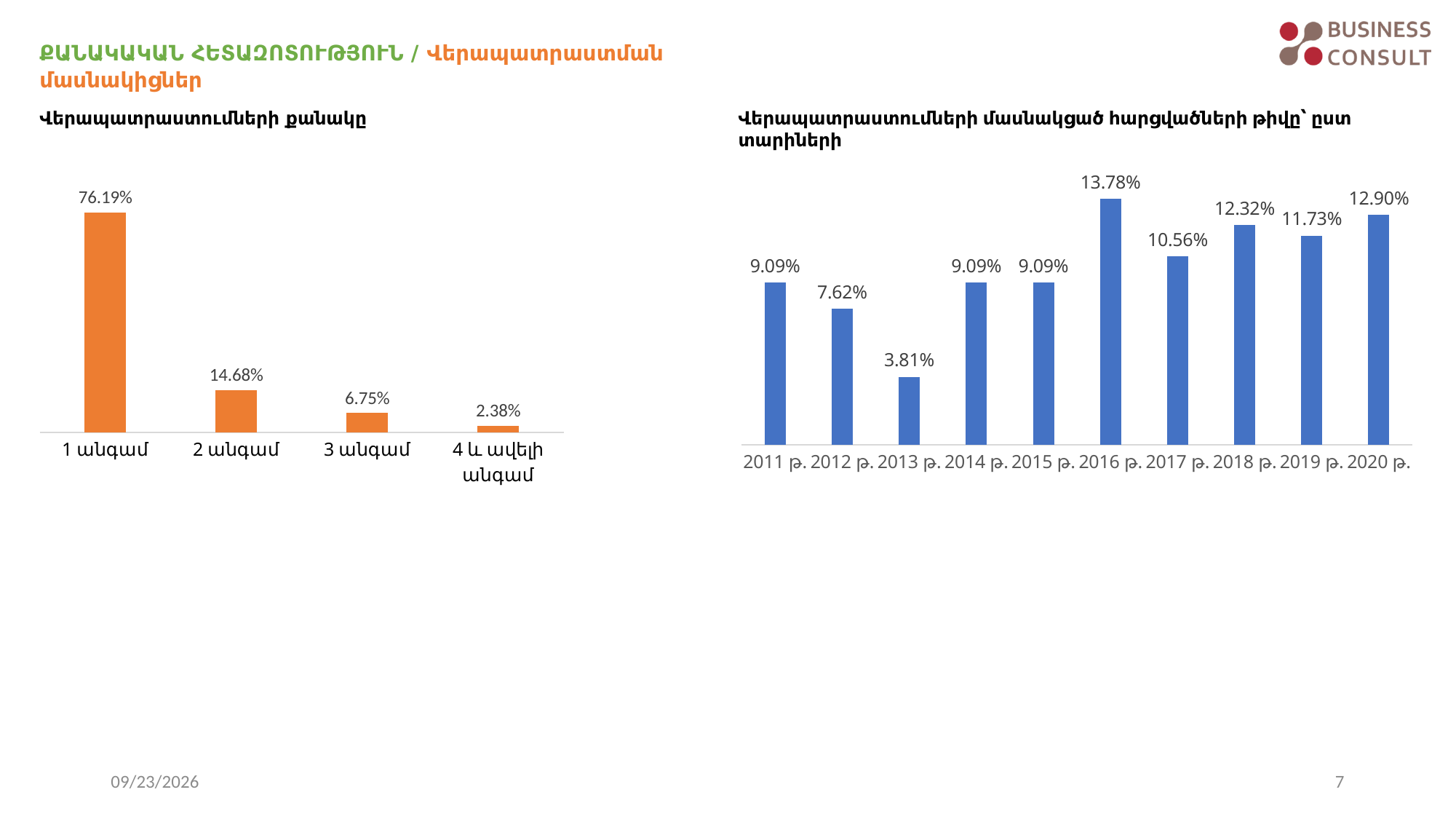
In the right chart, which year has the highest value? 2016 թ. In the right chart, what is the value for 2013 թ.? 3.81% What type of chart is the right chart? Bar chart In the right chart, which is larger: the value for 2017 թ. or the value for 2019 թ.? 2019 թ. In the left chart, what is the value for "1 անգամ"? 76.19% In the left chart, what is the difference between the values for "1 անգամ" and "2 անգամ"? 61.51% In the right chart, what is the difference between the values for 2020 թ. and 2012 թ.? 5.28% In the left chart, which category has the lowest value? 4 և ավելի անգամ In the right chart, what is the value for 2018 թ.? 12.32% In the right chart, which year has the lowest value? 2013 թ. In the left chart, what is the value for "3 անգամ"? 6.75% How many categories are shown in the left chart? 4